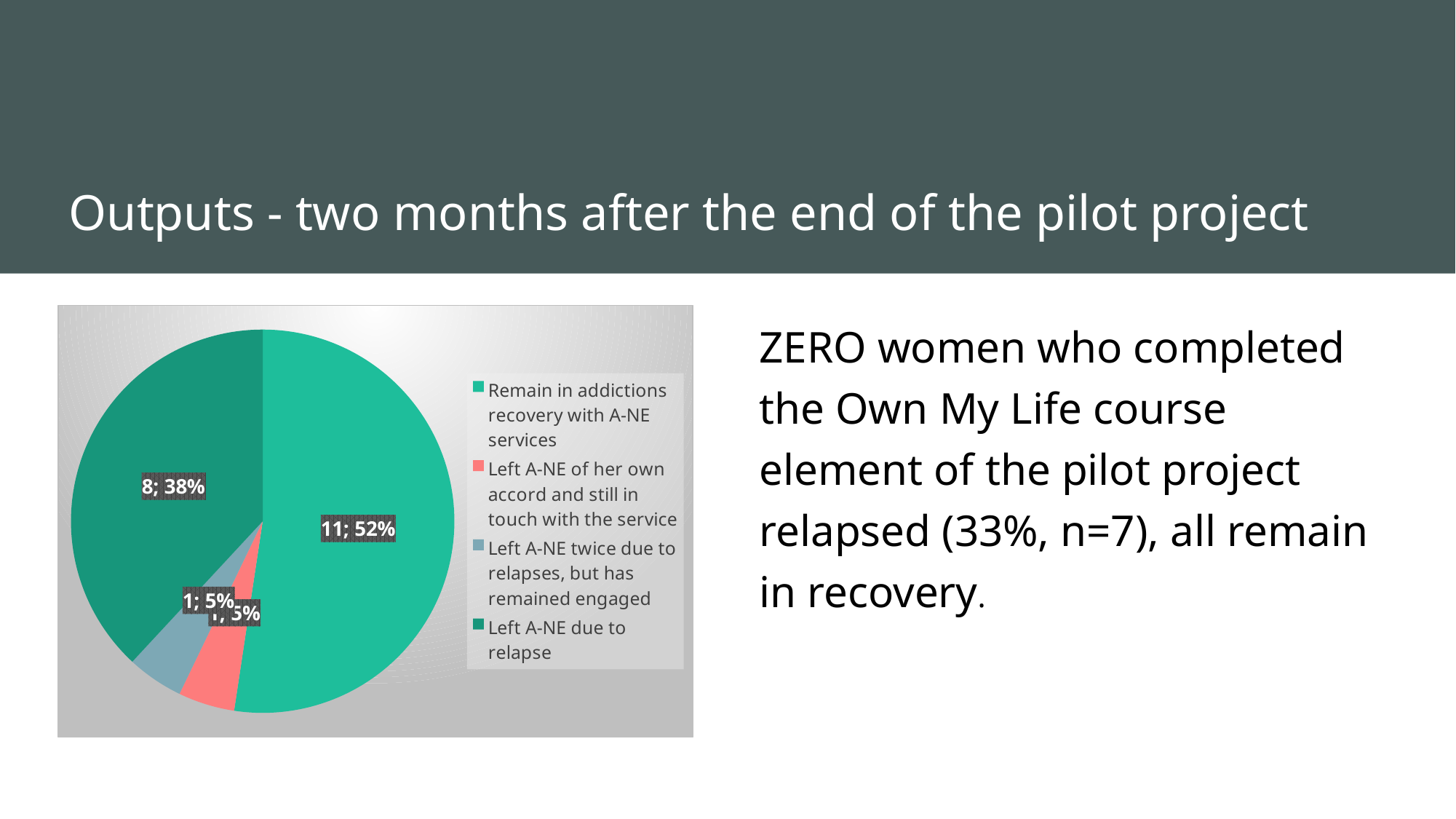
What percentage share of the pie does 'Left A-NE due to relapse' represent? 38% What is the data label for the 'Left A-NE due to relapse' slice? 8; 38% How many entries does the legend of the pie chart list? 4 What is the data label for the 'Remain in addictions recovery with A-NE services' slice? 11; 52% Which category has the largest slice of the pie? Remain in addictions recovery with A-NE services What kind of chart is shown on the slide? Pie chart What percentage share of the pie does 'Remain in addictions recovery with A-NE services' represent? 52% What colour is the 'Left A-NE of her own accord and still in touch with the service' slice? Pink What is the difference in count between 'Remain in addictions recovery with A-NE services' and 'Left A-NE due to relapse'? 3 Which is larger: the 'Left A-NE due to relapse' slice or the 'Left A-NE twice due to relapses, but has remained engaged' slice? Left A-NE due to relapse How many women are counted in the 'Left A-NE of her own accord and still in touch with the service' slice? 1 How many slices does the pie chart have? 4